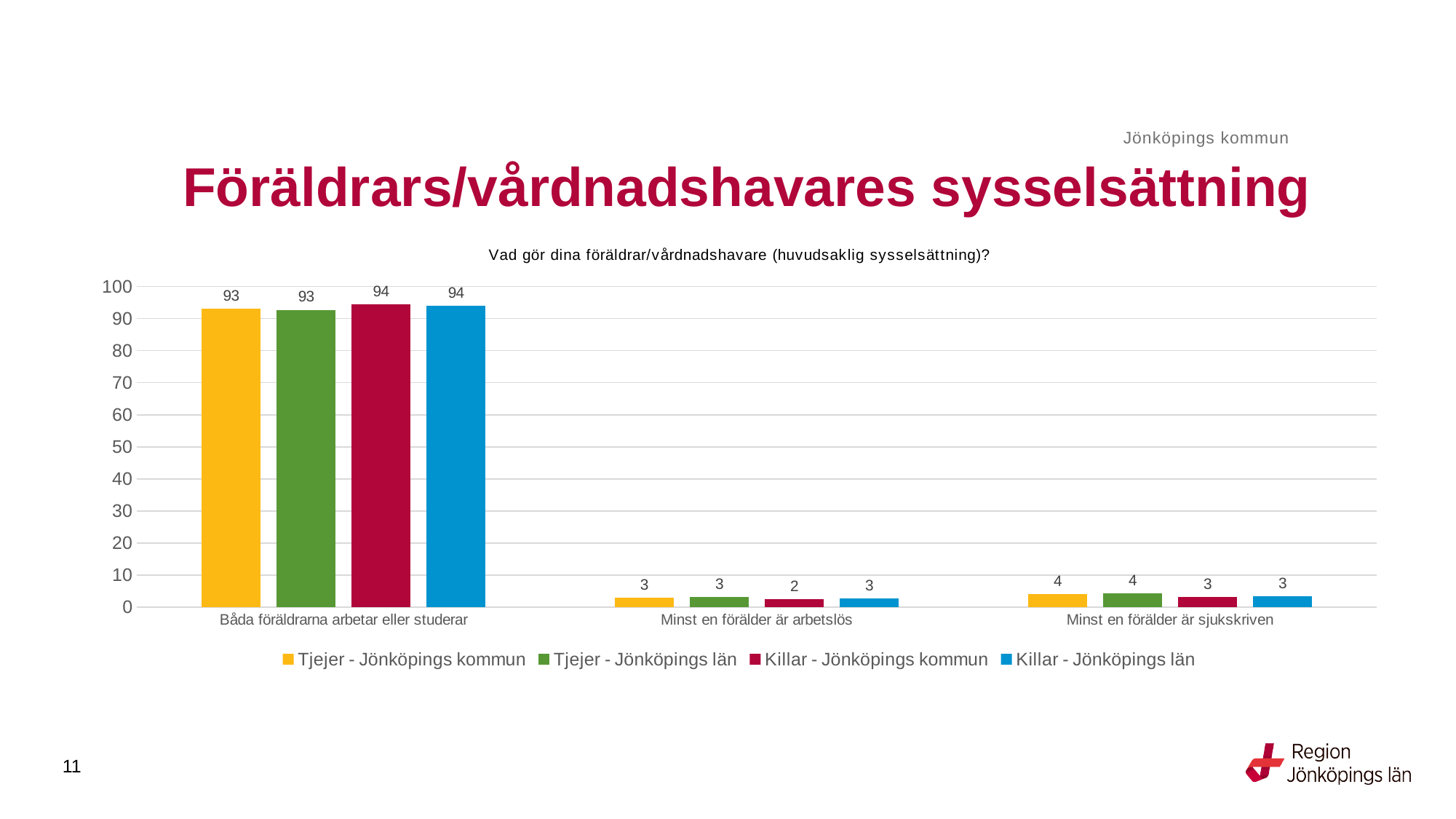
In the category 'Minst en förälder är sjukskriven', which is larger: the value for Tjejer - Jönköpings kommun or the value for Killar - Jönköpings kommun? Tjejer - Jönköpings kommun How many series does the legend list? 4 What is the value for Tjejer - Jönköpings kommun in the category 'Båda föräldrarna arbetar eller studerar'? 93 What is the question shown as the chart's title? Vad gör dina föräldrar/vårdnadshavare (huvudsaklig sysselsättning)? What is the value for Killar - Jönköpings län in the category 'Minst en förälder är arbetslös'? 3 What is the value for Tjejer - Jönköpings län in the category 'Minst en förälder är sjukskriven'? 4 How many categories are shown on the x axis? 3 What is the value for Killar - Jönköpings kommun in the category 'Minst en förälder är arbetslös'? 2 Is the value for Killar - Jönköpings län in 'Båda föräldrarna arbetar eller studerar' greater or less than 90? greater What is the difference between the Killar - Jönköpings kommun value and the Tjejer - Jönköpings kommun value in the category 'Båda föräldrarna arbetar eller studerar'? 1 Which category has the highest values across all series? Båda föräldrarna arbetar eller studerar What kind of chart is shown on the slide? bar chart